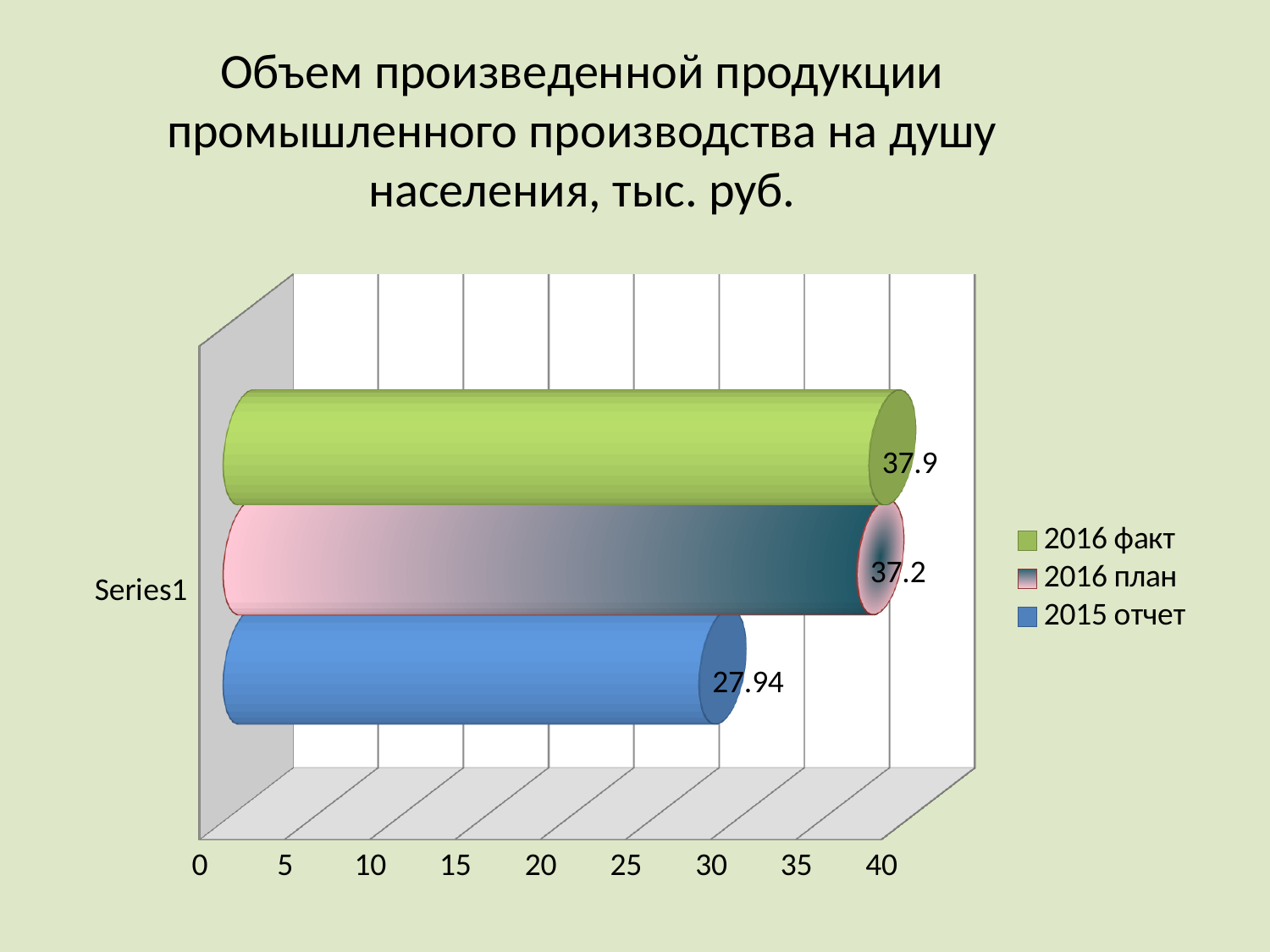
What is the value for 2016 план? 37.2 How many series does the legend list? 3 What is the value for 2016 факт? 37.9 What is the difference between the 2016 факт value and the 2015 отчет value? 9.96 What kind of chart is shown on the slide? bar chart Which series has the lowest value? 2015 отчет Which is larger, the value for 2016 план or the value for 2015 отчет? 2016 план What is the value for 2015 отчет? 27.94 Is the value for 2015 отчет greater or less than 30? less Is the value for 2016 факт greater or less than 35? greater What is the difference between the 2016 факт value and the 2016 план value? 0.7 What colour is the bar for 2016 факт? green